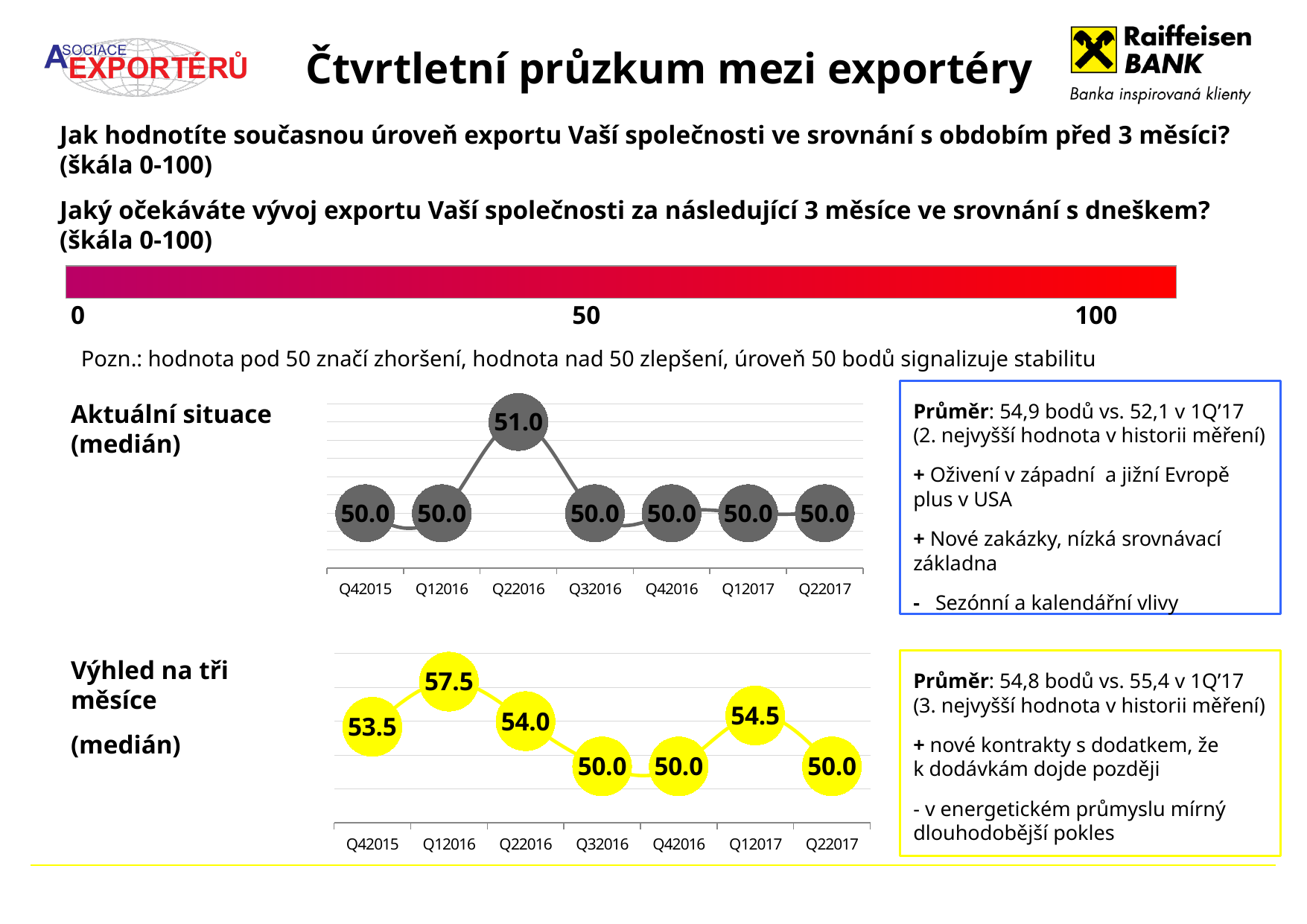
In the top chart (Aktuální situace), how many data points are plotted? 7 In the top chart (Aktuální situace), which quarter has the highest value? Q22016 In the bottom chart (Výhled na tři měsíce), what is the difference between the values for Q12016 and Q22016? 3.5 In the bottom chart (Výhled na tři měsíce), how many quarters have a value of 50.0? 3 In the bottom chart (Výhled na tři měsíce), what is the value for Q12017? 54.5 In the bottom chart (Výhled na tři měsíce), which quarter has the highest value? Q12016 What colour are the data point markers in the bottom chart (Výhled na tři měsíce)? yellow What kind of chart is the top chart (Aktuální situace)? line chart In the bottom chart (Výhled na tři měsíce), what is the value for Q12016? 57.5 In the bottom chart (Výhled na tři měsíce), which is larger, the value for Q42015 or the value for Q22016? Q22016 In the bottom chart (Výhled na tři měsíce), do the values rise or fall from Q12016 to Q32016? fall In the top chart (Aktuální situace), what is the value for Q22016? 51.0